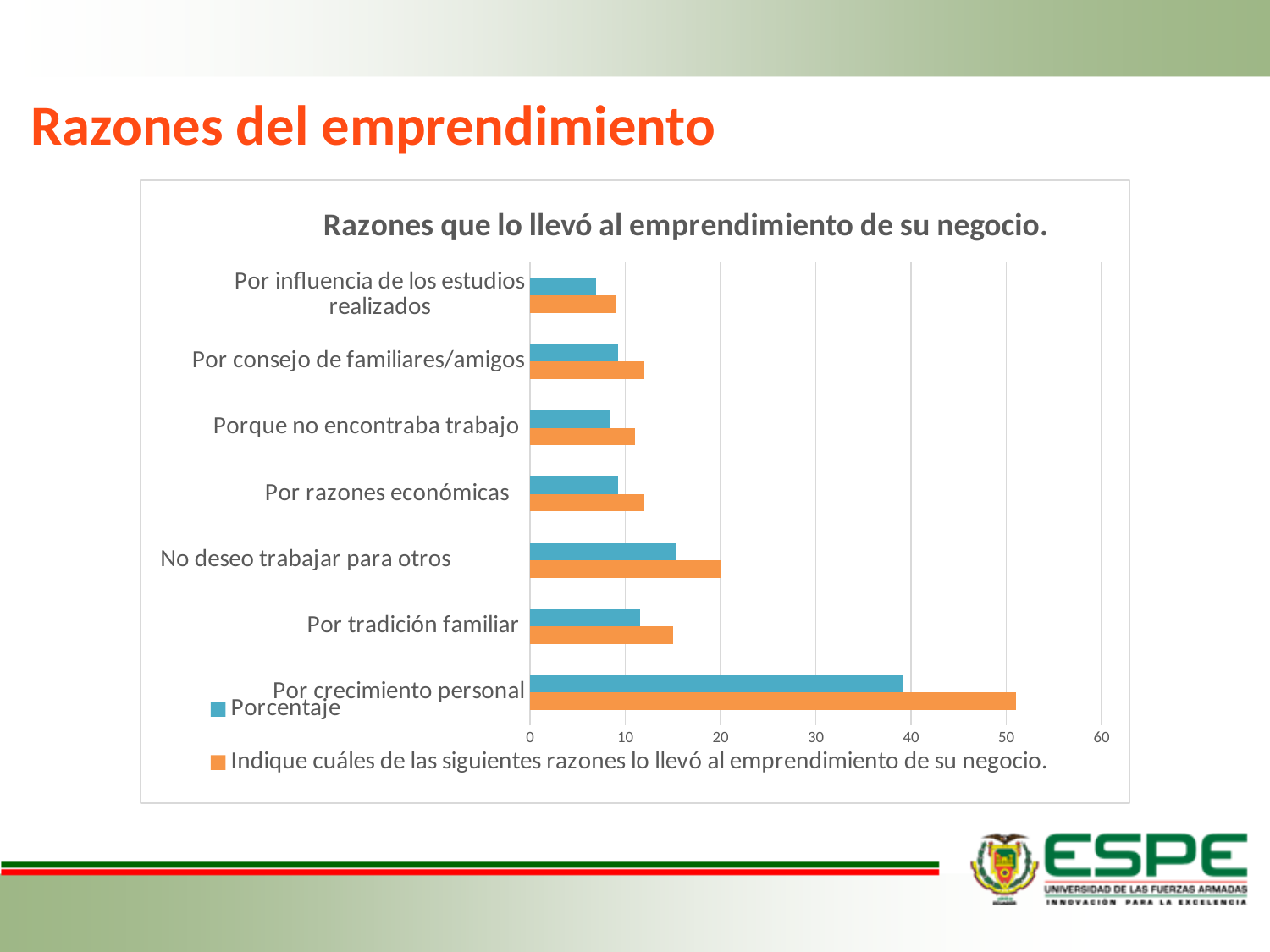
What kind of chart is shown on the slide? Bar chart How many reason categories are plotted in the chart? 7 Is the value for 'Por crecimiento personal' in the series 'Indique cuáles de las siguientes razones lo llevó al emprendimiento de su negocio.' greater or less than 40? greater Is the value for 'No deseo trabajar para otros' in the series 'Indique cuáles de las siguientes razones lo llevó al emprendimiento de su negocio.' greater or less than 30? less How many series does the chart legend list? 2 What is the title of the chart? Razones que lo llevó al emprendimiento de su negocio. Which category has the lowest value for the 'Porcentaje' series? Por influencia de los estudios realizados Which category has the highest value for the series 'Indique cuáles de las siguientes razones lo llevó al emprendimiento de su negocio.'? Por crecimiento personal For the 'Porcentaje' series, which is larger: 'Por crecimiento personal' or 'Por tradición familiar'? Por crecimiento personal What colour represents the 'Porcentaje' series in the chart? Blue Is the 'Porcentaje' value for 'Por crecimiento personal' greater or less than 30? greater For 'No deseo trabajar para otros', which series has the larger bar: 'Porcentaje' or 'Indique cuáles de las siguientes razones lo llevó al emprendimiento de su negocio.'? Indique cuáles de las siguientes razones lo llevó al emprendimiento de su negocio.